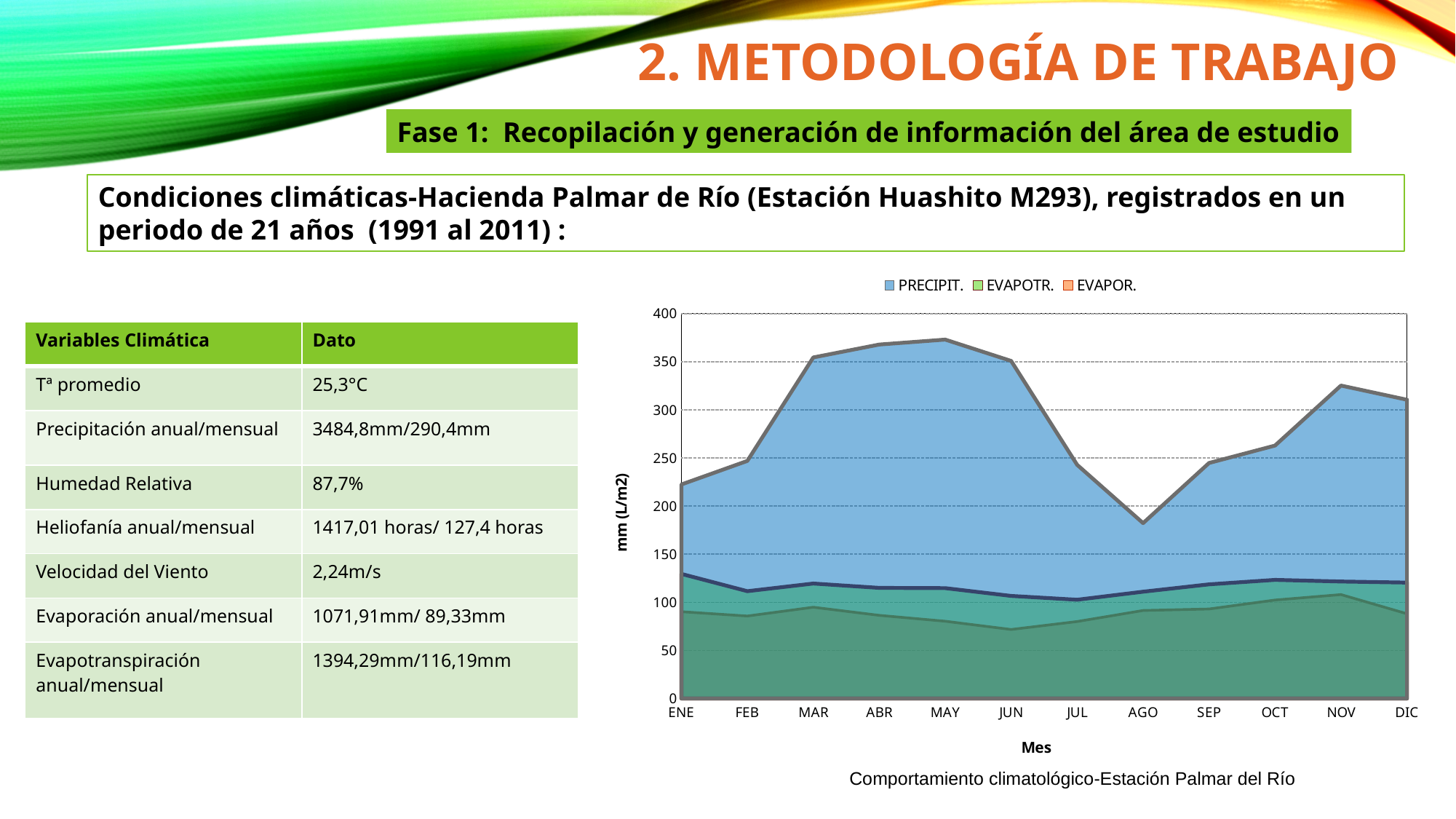
Is the PRECIPIT. value for MAY greater or less than 350? greater Is the PRECIPIT. value for NOV greater or less than 300? greater What kind of chart is shown on the slide? Area chart How many series does the chart legend list? 3 In which month is the PRECIPIT. value lowest? AGO Is the PRECIPIT. value for ENE greater or less than 200? greater What caption appears below the chart? Comportamiento climatológico-Estación Palmar del Río What is the label on the y axis of the chart? mm (L/m2) Which is larger, the PRECIPIT. value for MAR or for JUL? MAR Does the PRECIPIT. series rise or fall from MAY to AGO? Fall How many months are plotted along the x axis of the chart? 12